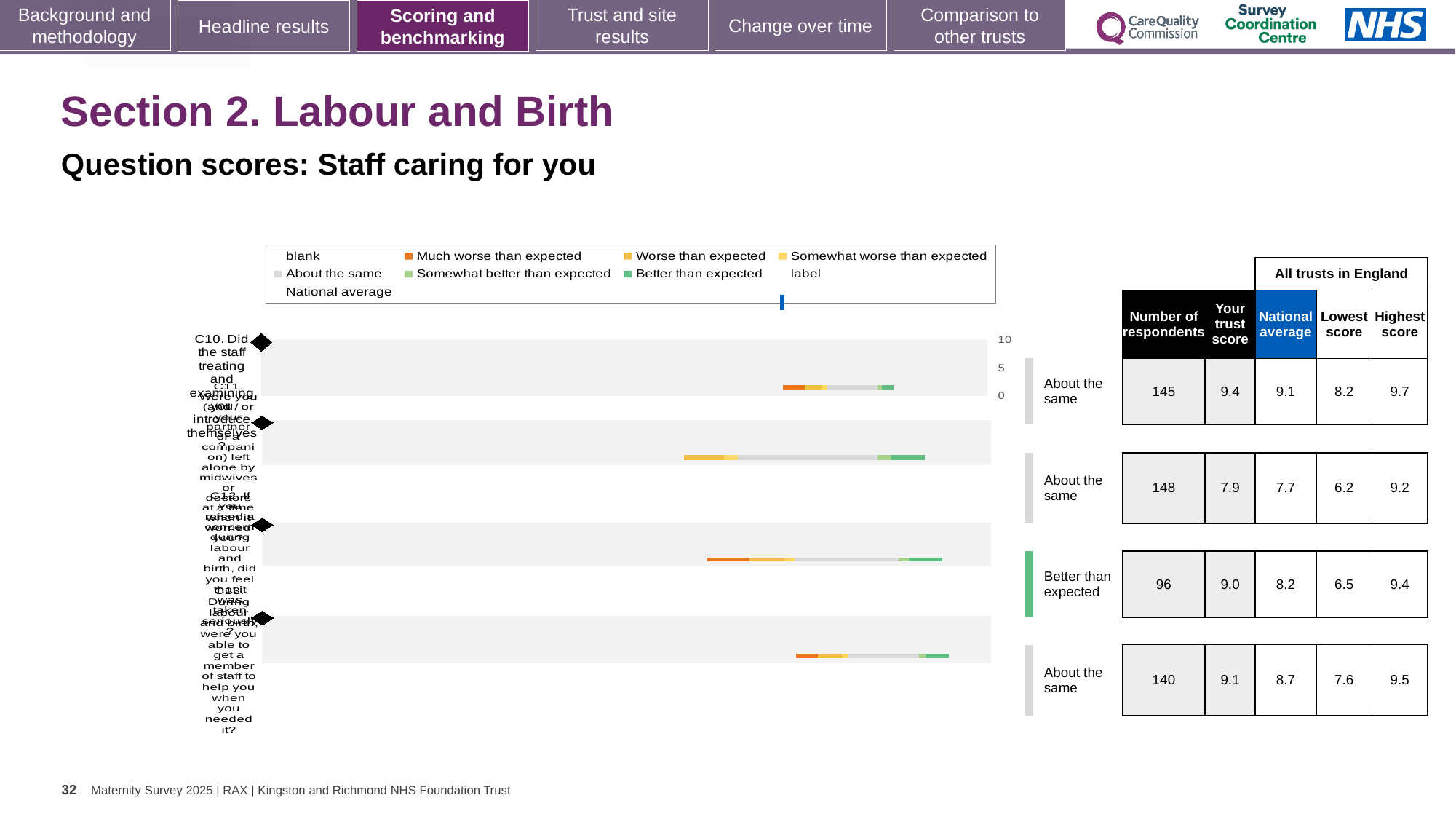
Which row is rated 'Better than expected'? the third row (C12) What is the highest score for the fourth row (C13)? 9.5 What kind of chart is shown on the slide? bar chart Which row has the lowest number of respondents? the third row (C12), 96 What is the 'Your trust score' for the second row (C11)? 7.9 How many question rows are plotted in the chart? 4 Which row has the highest 'Your trust score'? the first row (C10), 9.4 What is the number of respondents for the first row (C10)? 145 What is the national average for the third row (C12)? 8.2 What colour does the legend use for 'Much worse than expected'? orange For the first row (C10), what is the difference between the trust score and the national average? 0.3 For the second row (C11), is the trust score higher or lower than the national average? higher